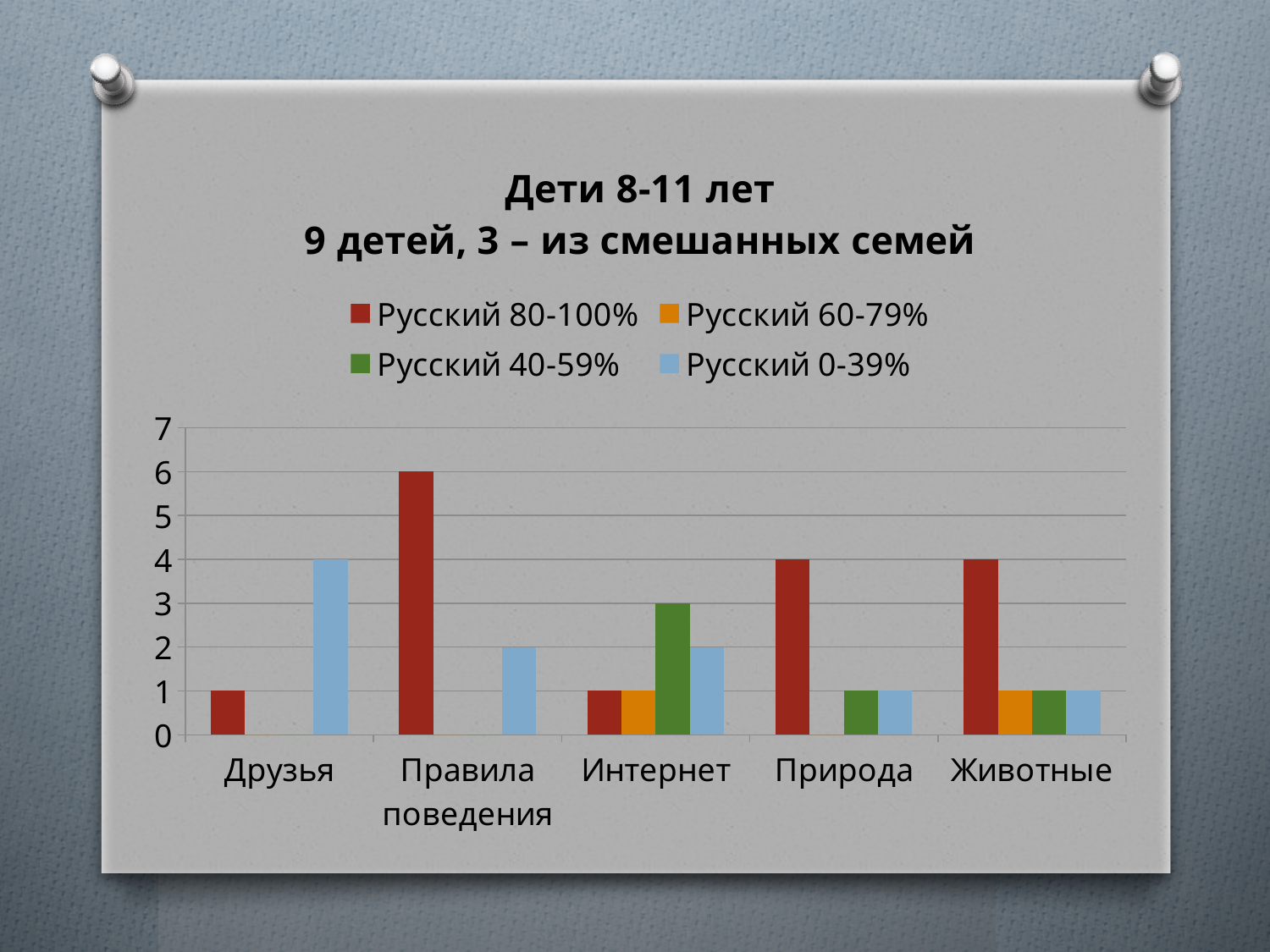
Which category has the highest value for Русский 80-100%? Правила поведения What is the value of Русский 80-100% for Правила поведения? 6 Which category has the highest value for Русский 0-39%? Друзья Is the value of Русский 80-100% for Правила поведения greater or less than 5? greater For Друзья, which is larger: Русский 80-100% or Русский 0-39%? Русский 0-39% What is the value of Русский 40-59% for Интернет? 3 What kind of chart is shown on the slide? bar chart How many series does the legend list? 4 What is the value of Русский 0-39% for Друзья? 4 What is the difference between Русский 80-100% for Правила поведения and Русский 80-100% for Природа? 2 What is the title of the chart? Дети 8-11 лет 9 детей, 3 – из смешанных семей How many categories are shown along the x axis? 5